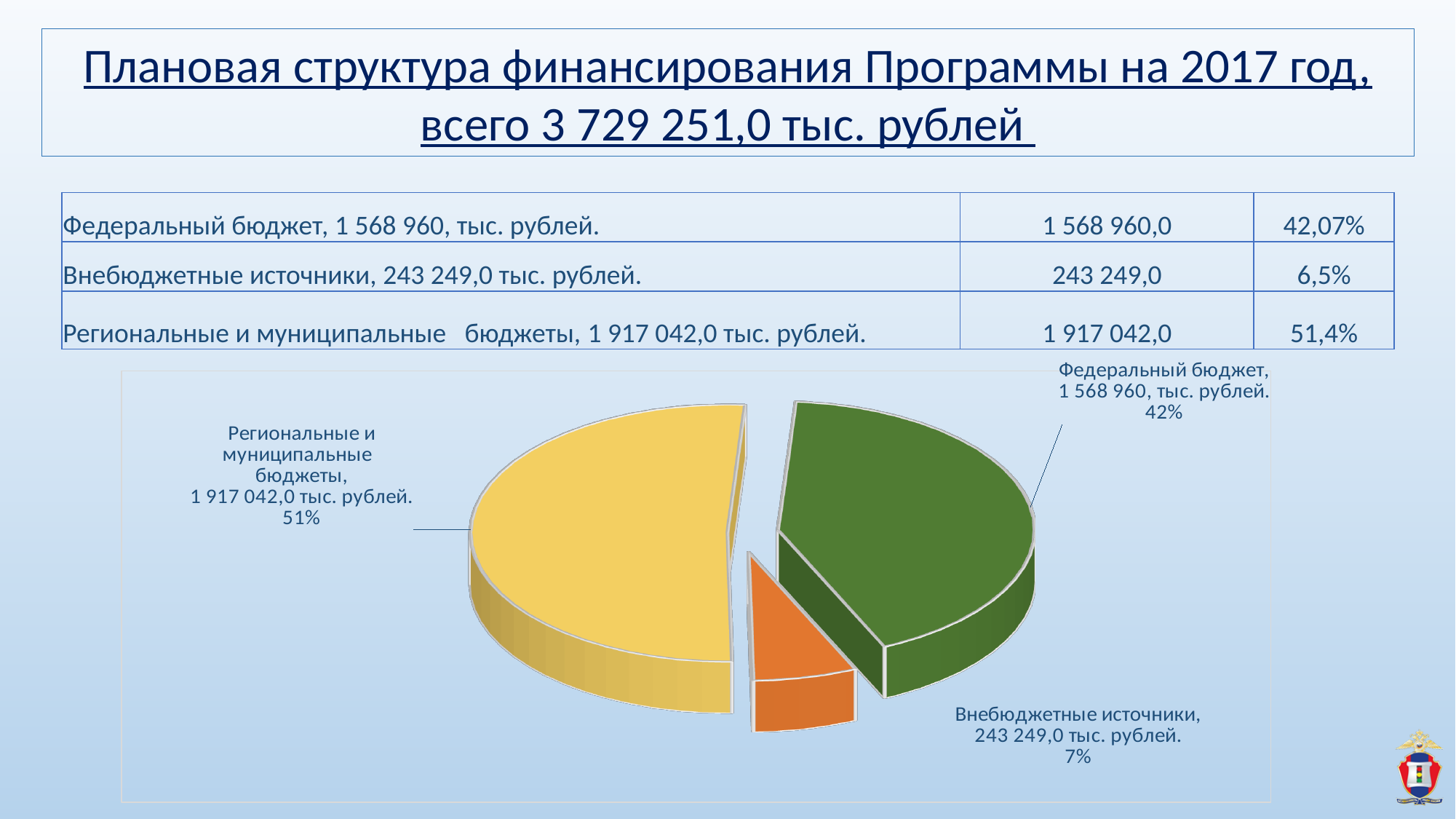
How many slices does the pie chart have? 3 What share of the pie does "Внебюджетные источники" represent? 7% What colour is the slice for "Федеральный бюджет" in the pie chart? Green What value is shown in the chart label for "Внебюджетные источники"? 243 249,0 тыс. рублей Which category has the smallest slice of the pie? Внебюджетные источники What share of the pie does "Региональные и муниципальные бюджеты" represent? 51% What share of the pie does "Федеральный бюджет" represent? 42% Which category has the largest slice of the pie? Региональные и муниципальные бюджеты By how many percentage points does the share of "Региональные и муниципальные бюджеты" exceed the share of "Федеральный бюджет" in the pie chart? 9 Which is larger in the pie chart: the share of "Федеральный бюджет" or the share of "Внебюджетные источники"? Федеральный бюджет What value is shown in the chart label for "Региональные и муниципальные бюджеты"? 1 917 042,0 тыс. рублей What kind of chart is shown on the slide? Pie chart